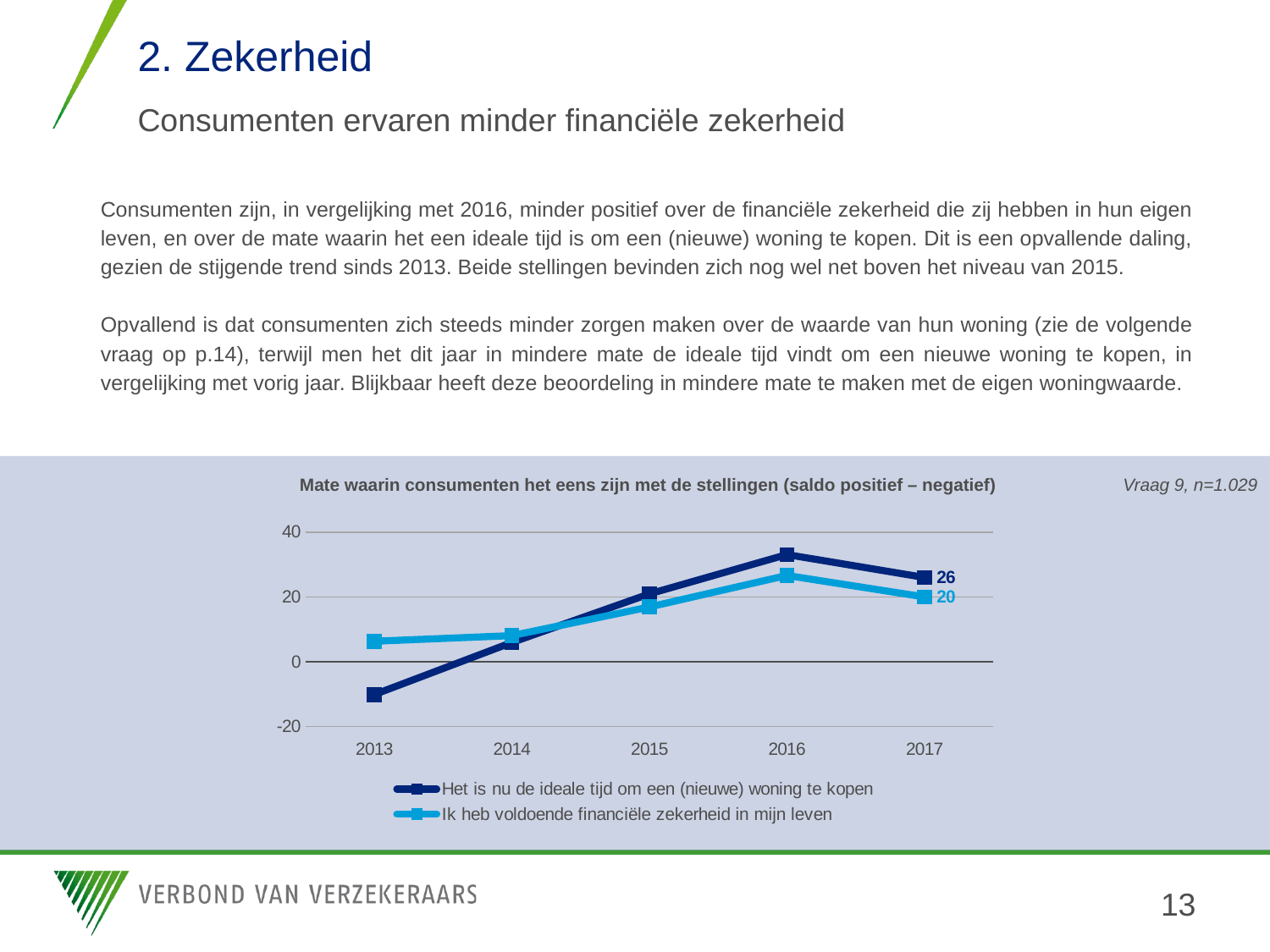
What kind of chart is shown on the slide? Line chart What is the value for 'Het is nu de ideale tijd om een (nieuwe) woning te kopen' in 2017? 26 How many series does the legend list? 2 What is the difference between the two series' values in 2017? 6 What is the value for 'Ik heb voldoende financiële zekerheid in mijn leven' in 2017? 20 Is the value for 'Het is nu de ideale tijd om een (nieuwe) woning te kopen' in 2013 greater or less than 0? less Is the value for 'Ik heb voldoende financiële zekerheid in mijn leven' in 2016 greater or less than 20? greater Does the value for 'Het is nu de ideale tijd om een (nieuwe) woning te kopen' rise or fall from 2013 to 2016? rise In which year does 'Het is nu de ideale tijd om een (nieuwe) woning te kopen' have its lowest value? 2013 How many years are plotted on the x axis? 5 In which year does 'Het is nu de ideale tijd om een (nieuwe) woning te kopen' reach its highest value? 2016 Which series has the higher value in 2017? Het is nu de ideale tijd om een (nieuwe) woning te kopen